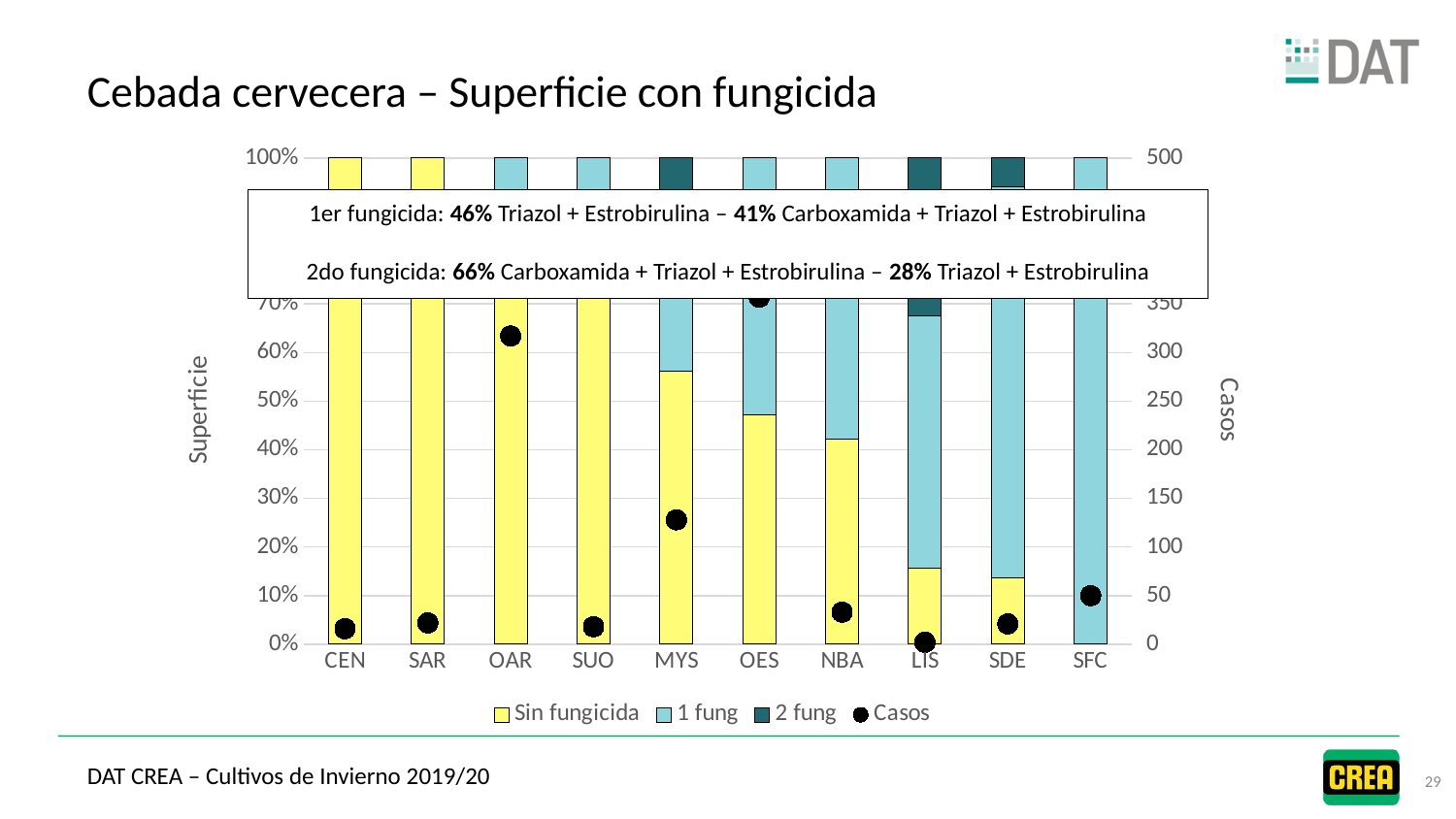
What is the label of the right-hand vertical axis? Casos What is the title of the slide's chart? Cebada cervecera – Superficie con fungicida Is the 'Sin fungicida' share for SFC greater or less than 10%? less Is the 'Sin fungicida' share for CEN greater or less than 90%? greater Which category has the lowest number of 'Casos'? LIS How many categories are shown along the x axis of the chart? 10 What kind of chart is shown on the slide? A combination chart: 100% stacked bars with a dot (marker) series for Casos Is the 'Sin fungicida' share for MYS greater or less than 50%? greater How many series does the chart legend list? 4 Which has the larger 'Sin fungicida' share, MYS or OES? MYS